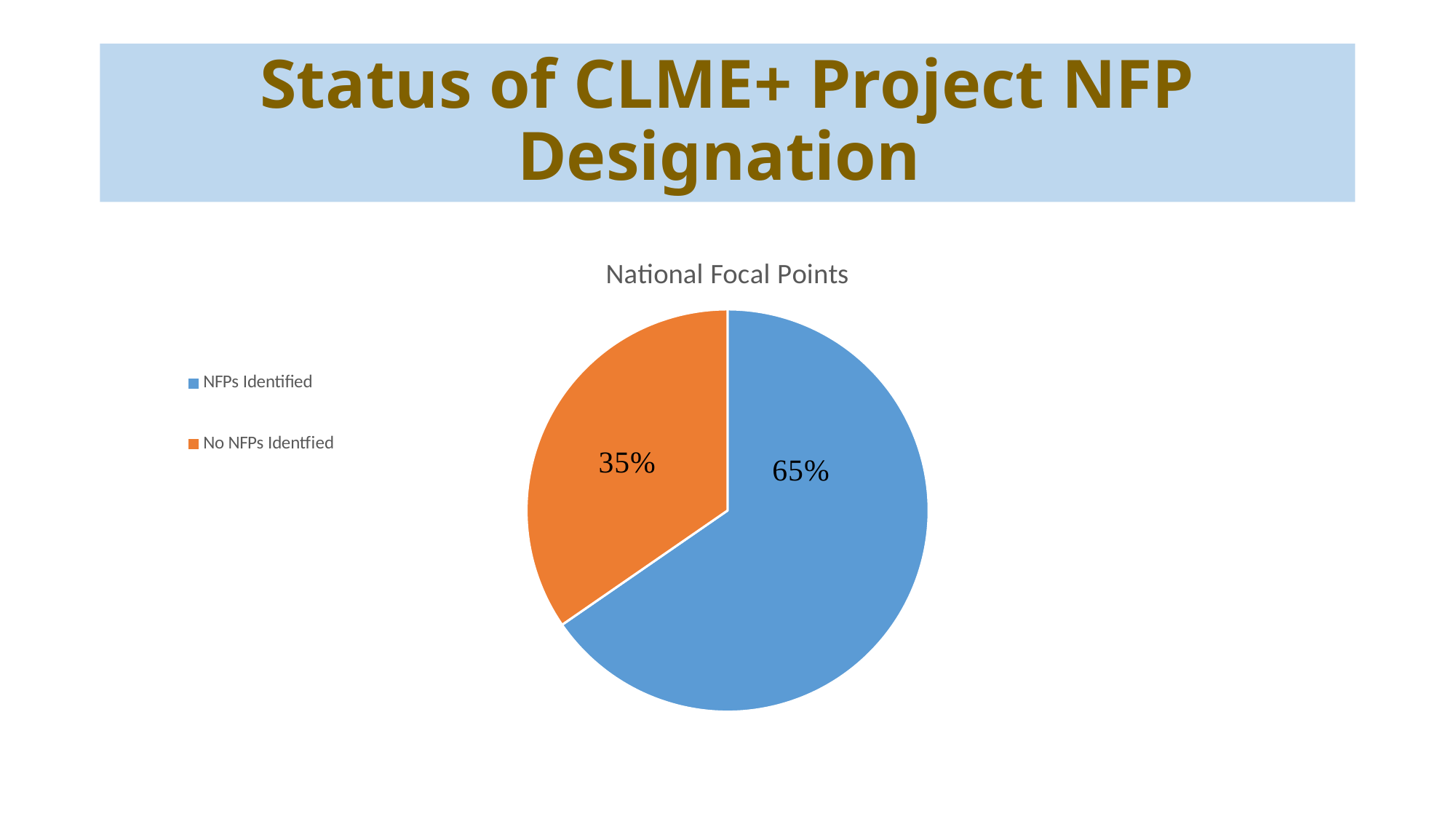
What share of the pie is labelled No NFPs Identfied? 35% What colour is the NFPs Identified slice? blue Which slice is the smallest? No NFPs Identfied Which is larger, the NFPs Identified slice or the No NFPs Identfied slice? NFPs Identified Which slice is the largest? NFPs Identified How many slices does the pie chart have? 2 What is the title of the chart? National Focal Points What share of the pie is labelled NFPs Identified? 65% What is the difference in percentage points between the NFPs Identified slice and the No NFPs Identfied slice? 30 What kind of chart is shown on the slide? pie chart How many entries does the legend list? 2